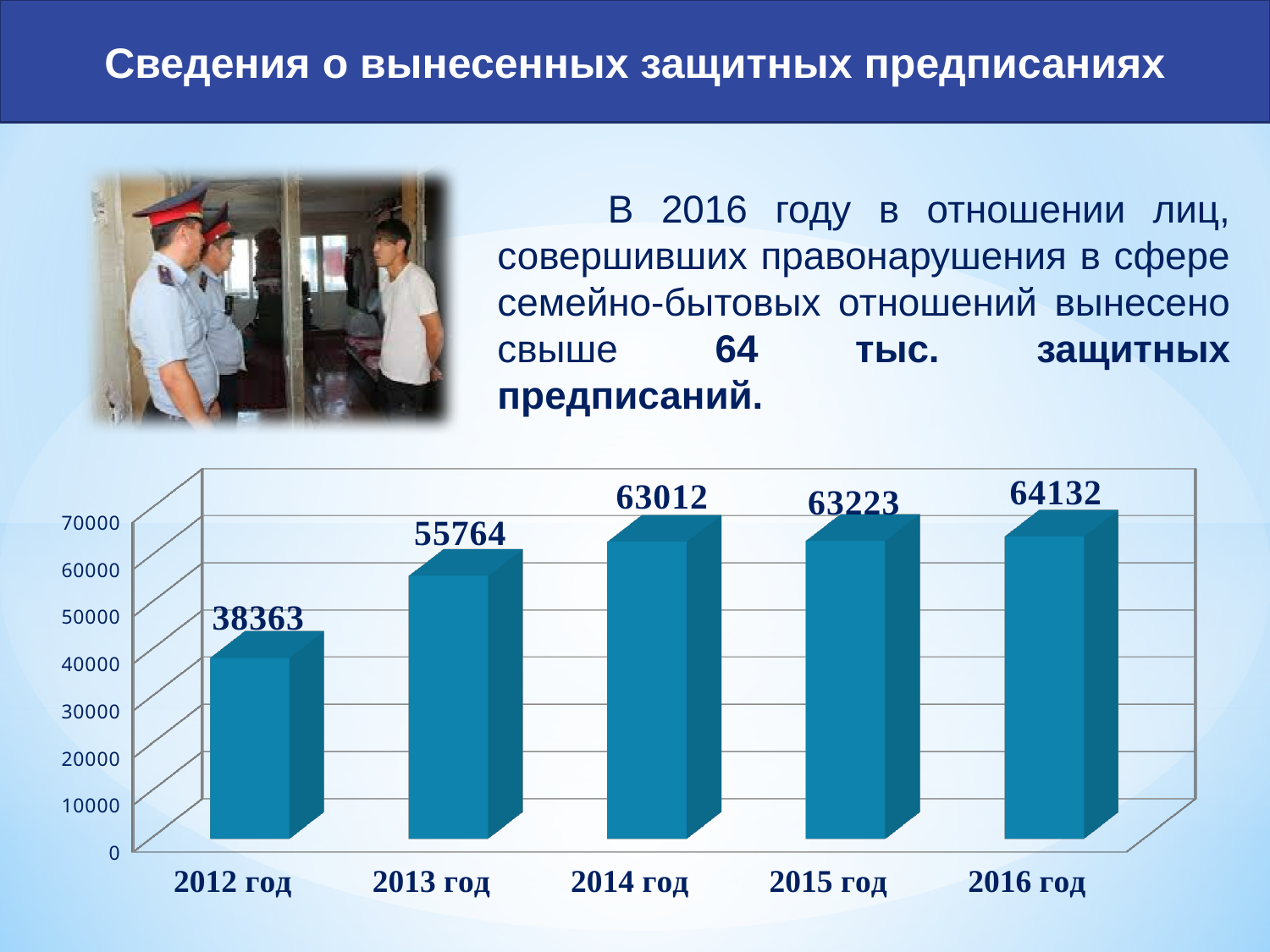
How many years are shown on the chart? 5 What value is shown for 2016 год? 64132 What kind of chart is shown on the slide? bar chart Which year has the lowest value? 2012 год What value is shown for 2012 год? 38363 Which year has the highest value? 2016 год What value is shown for 2014 год? 63012 Which is larger, the value for 2013 год or the value for 2014 год? 2014 год Do the values rise or fall from 2012 год to 2016 год? rise Is the value for 2012 год greater or less than 40000? less What is the difference between the values for 2013 год and 2012 год? 17401 What is the difference between the values for 2016 год and 2012 год? 25769